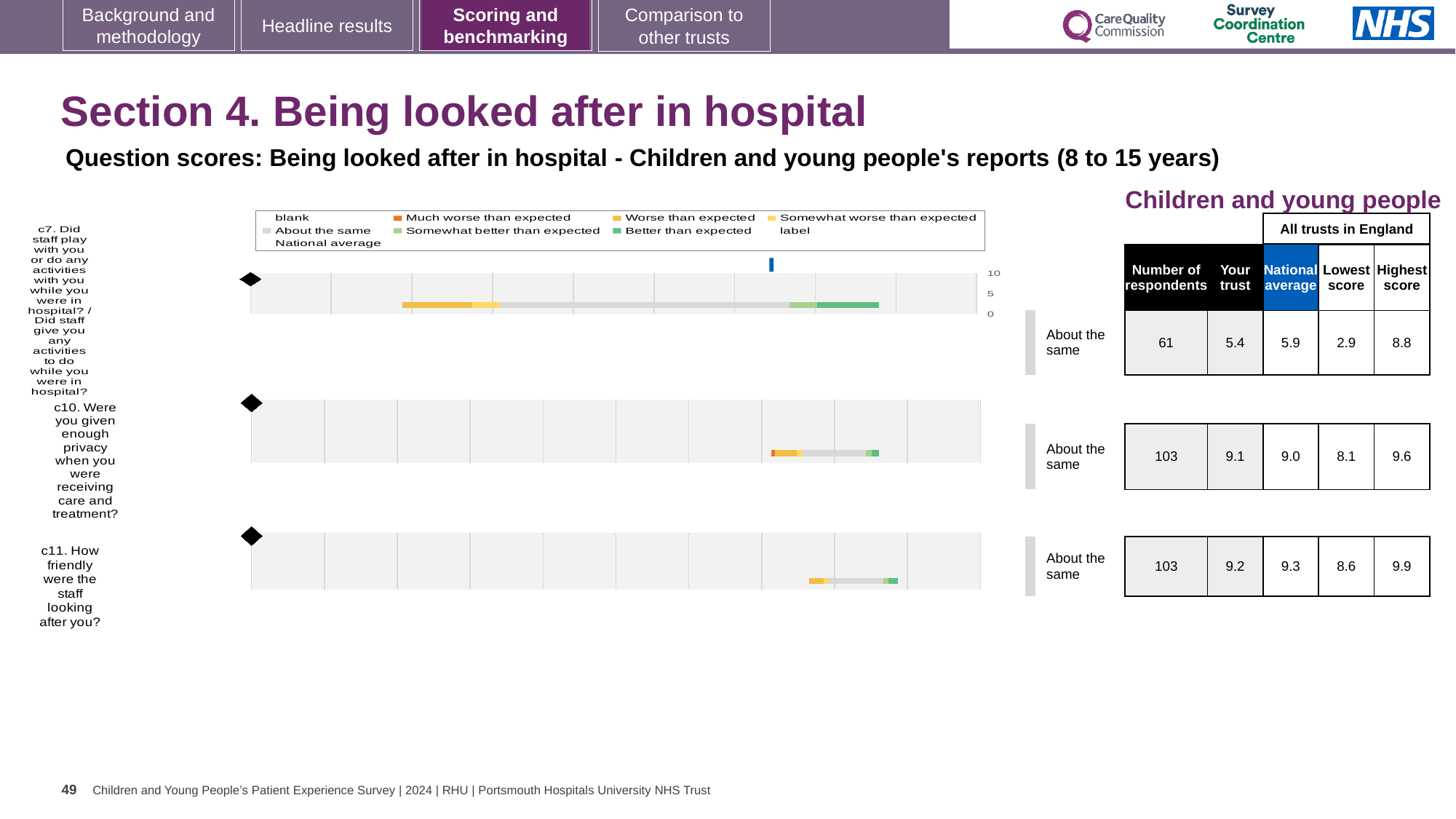
How many questions are plotted on this slide? 3 For question c11, what is the difference between the highest score and the lowest score across all trusts in England? 1.3 Which question has the highest 'Your trust' score? c11. How friendly were the staff looking after you? What benchmark category is shown for question c7? About the same For question c7, which is larger: the 'Your trust' score or the national average? National average What is the 'Your trust' score for question c10 (Were you given enough privacy when you were receiving care and treatment?)? 9.1 Which question has the lowest number of respondents? c7. Did staff play with you or do any activities with you while you were in hospital? What is the national average score for question c11 (How friendly were the staff looking after you?)? 9.3 What is the lowest score across all trusts in England for question c7? 2.9 What is the highest score across all trusts in England for question c10? 9.6 What kind of chart is used to show the question scores on this slide? Bar chart How many respondents answered question c7 (Did staff play with you or do any activities with you while you were in hospital?)? 61